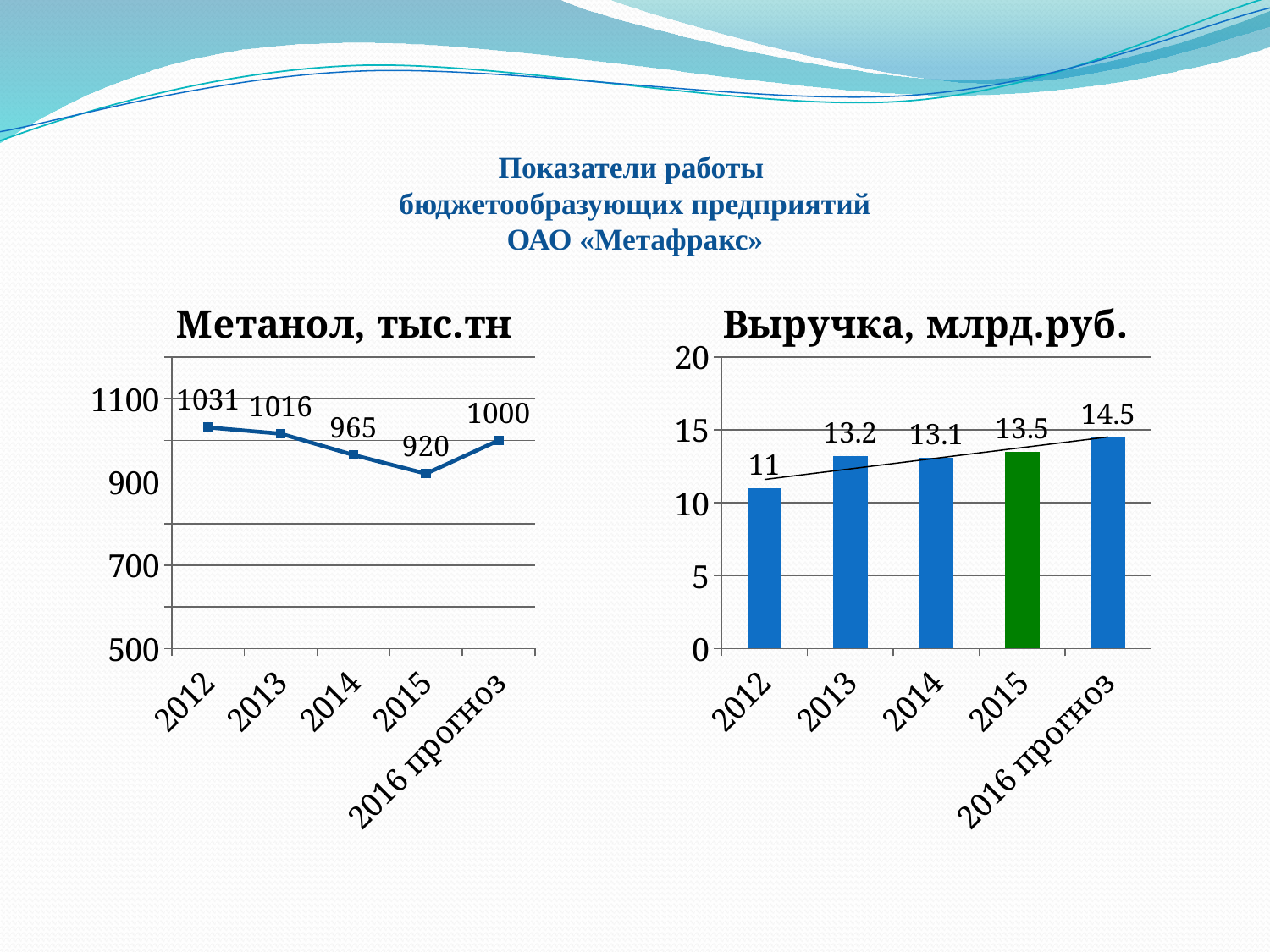
In the "Выручка, млрд.руб." chart, which bar is coloured green? 2015 In the "Выручка, млрд.руб." chart, which year has the lowest value? 2012 In the "Метанол, тыс.тн" chart, what is the value for 2012? 1031 How many categories are shown on the x axis of the "Выручка, млрд.руб." chart? 5 In the "Метанол, тыс.тн" chart, what is the difference between the 2012 value and the 2015 value? 111 What kind of chart is the "Метанол, тыс.тн" chart? line chart In the "Метанол, тыс.тн" chart, what is the value for 2015? 920 In the "Выручка, млрд.руб." chart, what is the difference between the 2016 прогноз value and the 2012 value? 3.5 In the "Выручка, млрд.руб." chart, what is the value for 2012? 11 In the "Выручка, млрд.руб." chart, what is the value for 2016 прогноз? 14.5 In the "Метанол, тыс.тн" chart, which year has the lowest value? 2015 In the "Метанол, тыс.тн" chart, which year has the highest value? 2012